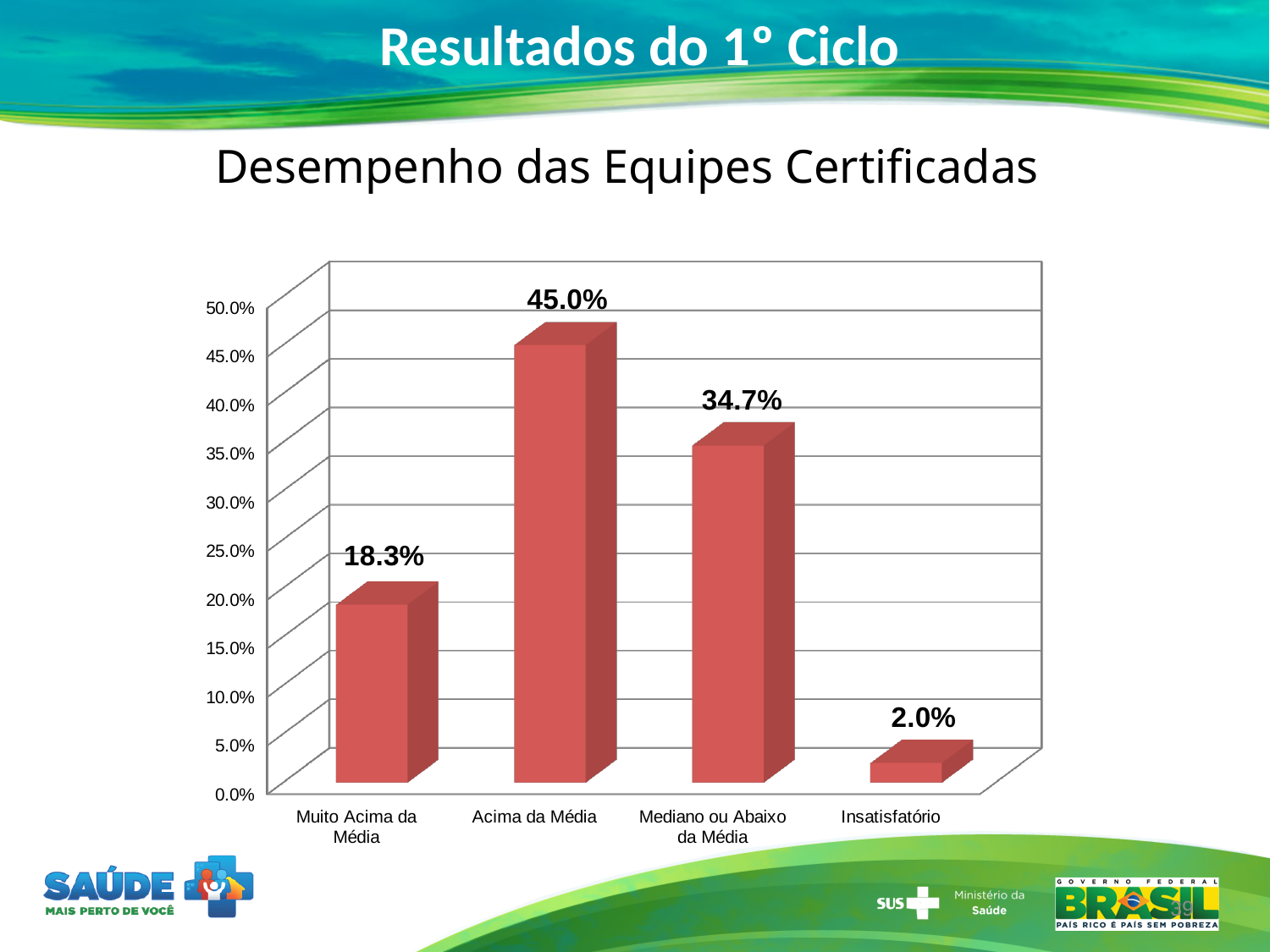
What is the value for Insatisfatório? 2.0% What is the value for Acima da Média? 45.0% How many categories are shown on the x axis? 4 Which category has the lowest value? Insatisfatório Which category has the highest value? Acima da Média What is the value for Mediano ou Abaixo da Média? 34.7% What is the difference between the values for Muito Acima da Média and Insatisfatório? 16.3% What kind of chart is shown on the slide? bar chart Which is larger, the value for Muito Acima da Média or the value for Mediano ou Abaixo da Média? Mediano ou Abaixo da Média What is the difference between the values for Acima da Média and Mediano ou Abaixo da Média? 10.3% What is the value for Muito Acima da Média? 18.3% What is the title shown above the chart? Desempenho das Equipes Certificadas